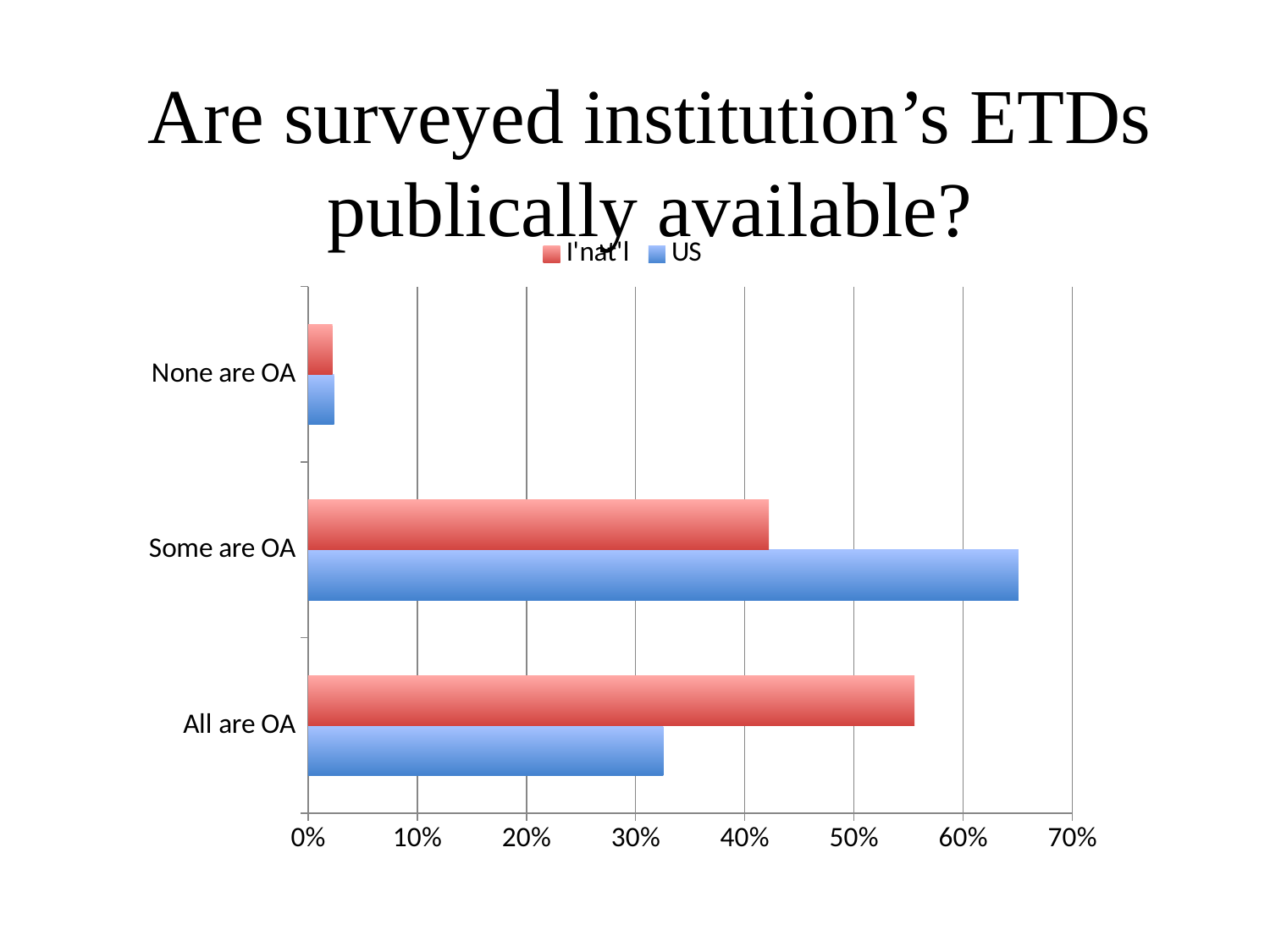
Is the I'nat'l value for Some are OA greater or less than 50%? less Is the US value for All are OA greater or less than 40%? less Is the US value for None are OA greater or less than 10%? less Which series is shown in blue? US How many series does the legend list? 2 For Some are OA, which series has the larger value, I'nat'l or US? US For All are OA, which series has the larger value, I'nat'l or US? I'nat'l Which category has the lowest US value? None are OA How many categories are shown on the chart? 3 What kind of chart is shown on the slide? bar chart